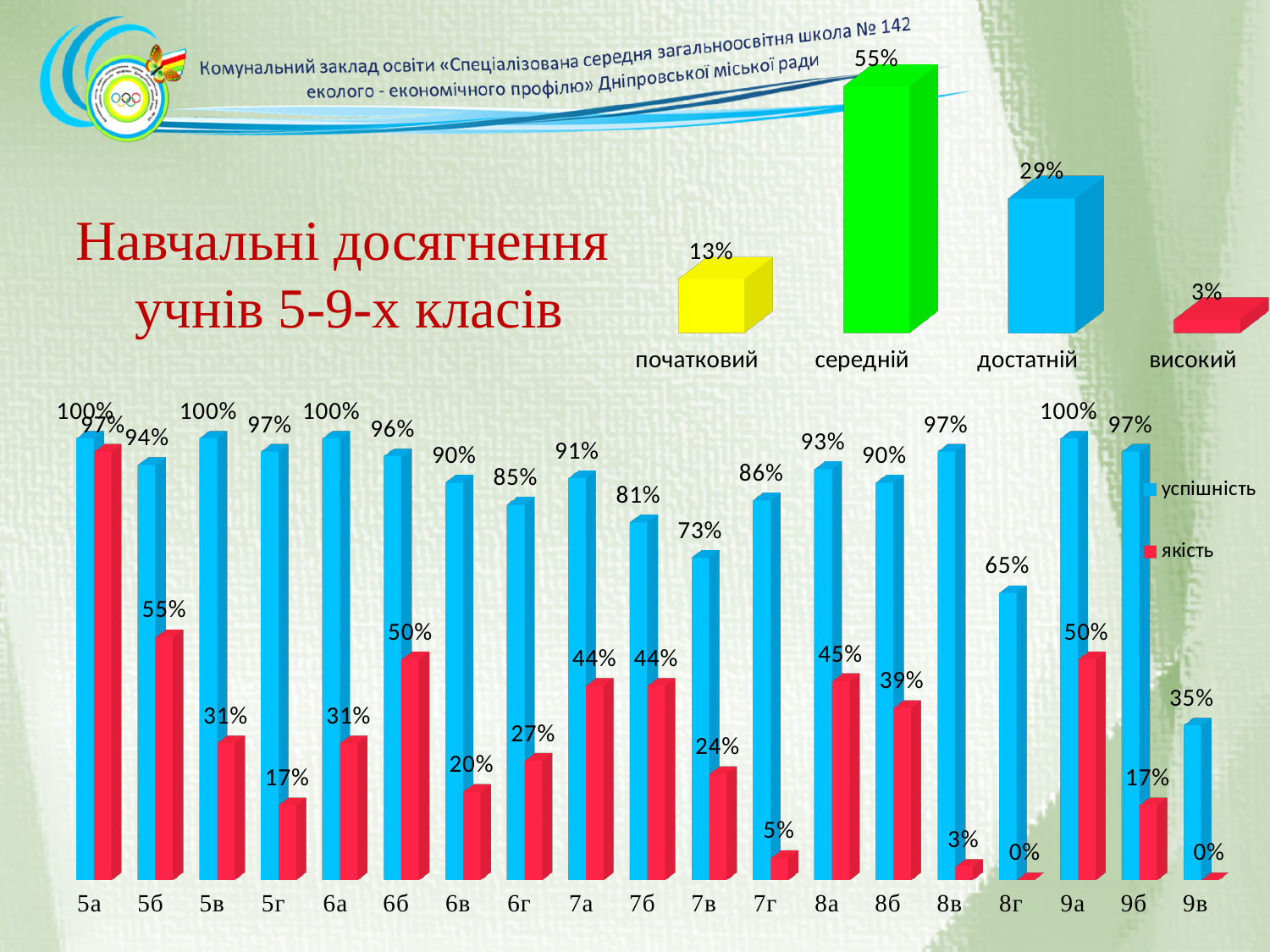
How many classes are shown on the x axis of the bottom chart? 19 How many categories does the top-right chart show? 4 In the bottom chart, which class has the lowest успішність value? 9в In the top-right chart, which category has the lowest value? високий In the bottom chart, what is the успішність value for class 7в? 73% In the bottom chart, what is the якість value for class 5б? 55% In the top-right chart, what is the difference between достатній and початковий? 16% In the top-right chart, what is the value for середній? 55% In the bottom chart, what is the difference between успішність and якість for class 8в? 94% What type of chart is the bottom chart? bar chart In the bottom chart, which is larger: the якість value for 6б or for 8б? 6б How many series does the legend of the bottom chart list? 2